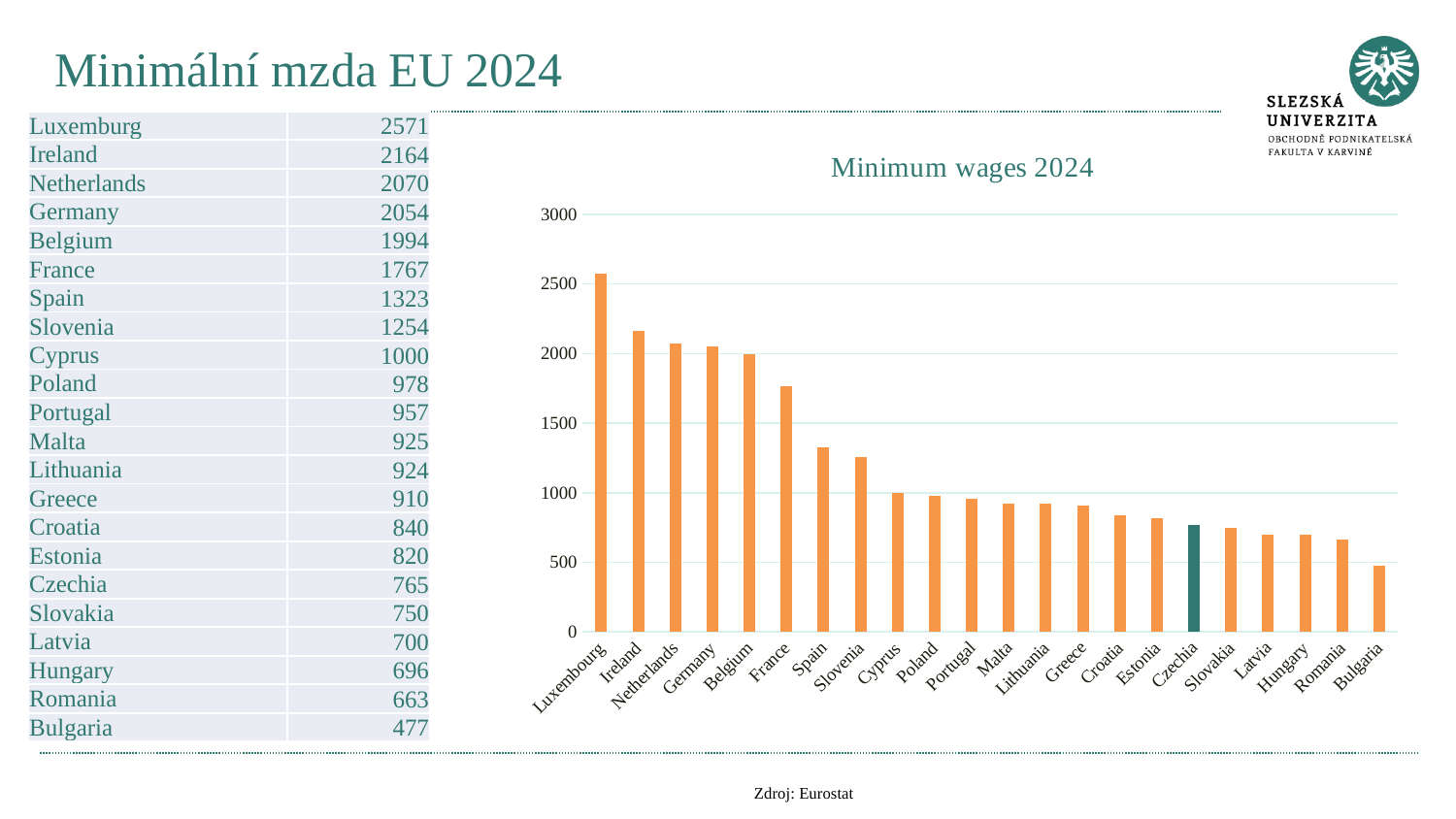
Do the values rise or fall from left to right along the x axis? fall What is the difference between the minimum wage of Ireland and Germany? 110 What is the minimum wage value for Czechia? 765 What is the minimum wage value for Luxembourg? 2571 How many countries are shown in the chart? 22 What kind of chart is shown on the slide? bar chart What is the title of the chart? Minimum wages 2024 Which country has the lowest minimum wage in the chart? Bulgaria Which has a higher minimum wage, Spain or Slovenia? Spain Which country's bar is shown in a different colour from the others? Czechia Which country has the highest minimum wage in the chart? Luxembourg Is the value for France greater or less than 1500? greater